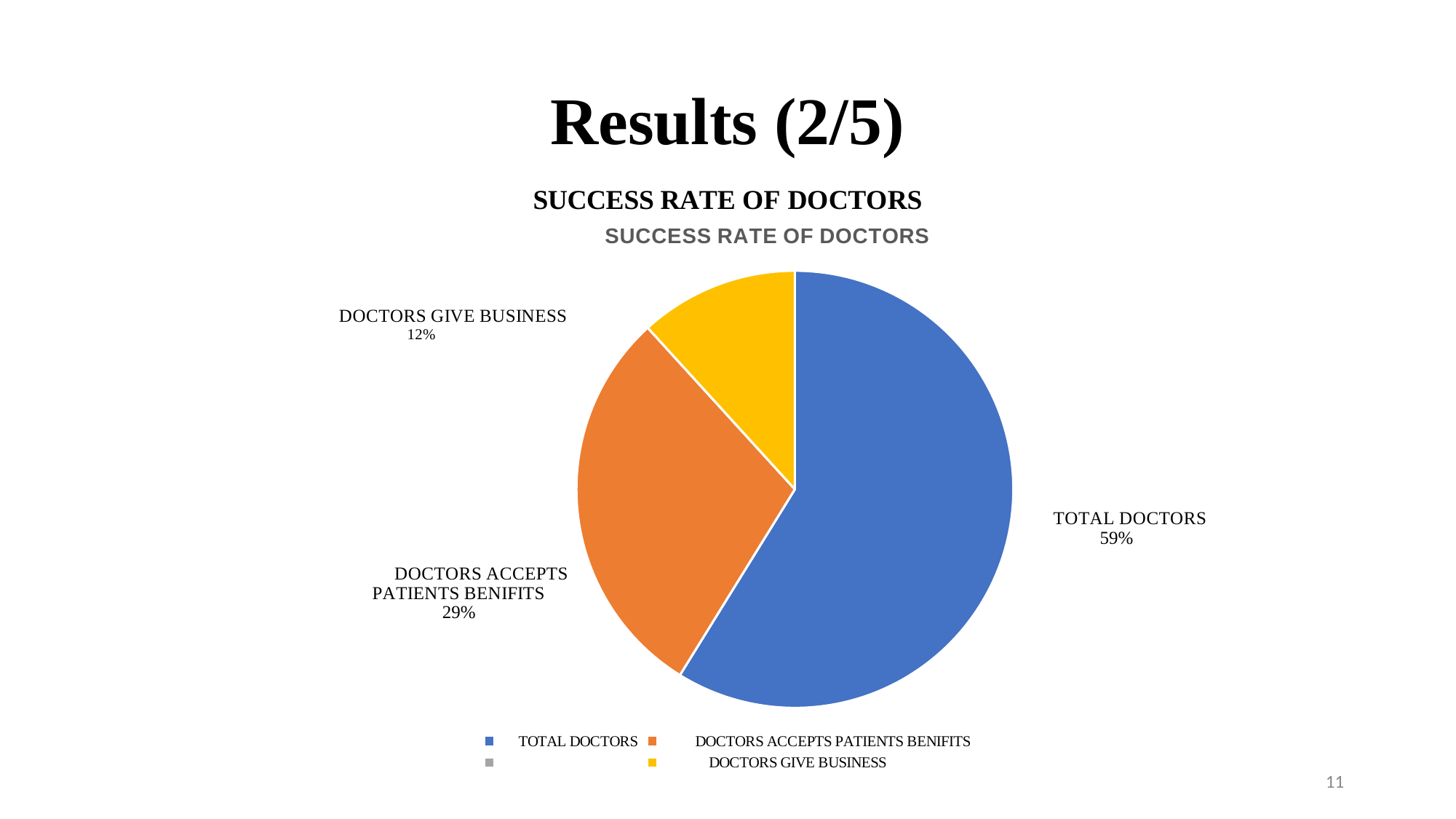
What percentage of the pie is DOCTORS GIVE BUSINESS? 12% What is the title of the chart? SUCCESS RATE OF DOCTORS Which slice of the pie is the largest? TOTAL DOCTORS Which slice of the pie is the smallest? DOCTORS GIVE BUSINESS What colour is the TOTAL DOCTORS slice? blue How many slices does the pie chart have? 3 What percentage of the pie is TOTAL DOCTORS? 59% What is the difference in percentage points between DOCTORS ACCEPTS PATIENTS BENIFITS and DOCTORS GIVE BUSINESS? 17 What percentage of the pie is DOCTORS ACCEPTS PATIENTS BENIFITS? 29% What is the difference in percentage points between TOTAL DOCTORS and DOCTORS ACCEPTS PATIENTS BENIFITS? 30 What type of chart is shown on the slide? pie chart Which is larger, the DOCTORS ACCEPTS PATIENTS BENIFITS slice or the DOCTORS GIVE BUSINESS slice? DOCTORS ACCEPTS PATIENTS BENIFITS